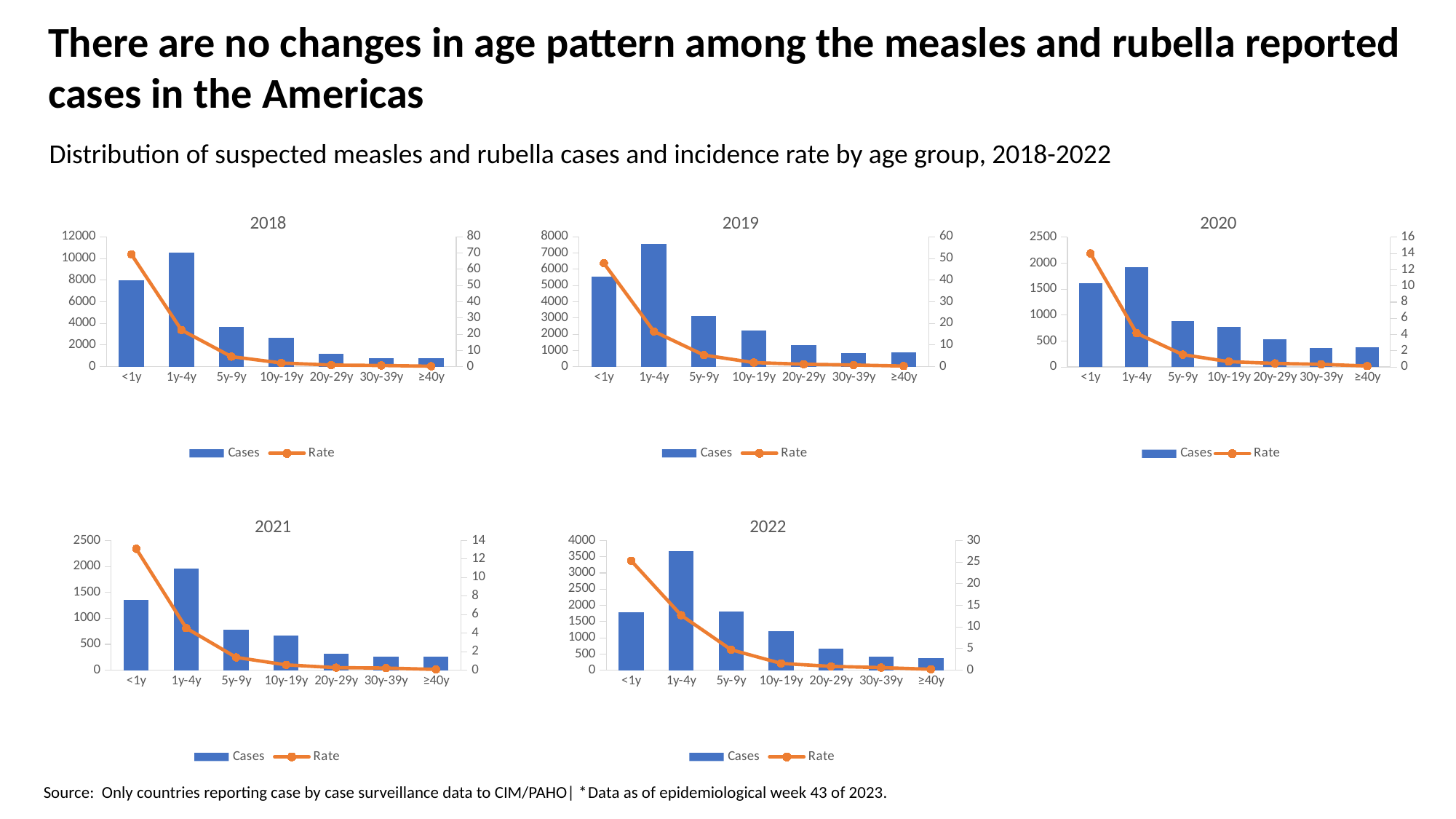
On the 2018 chart, is the number of cases for <1y greater or less than 6000? greater On the 2019 chart, is the number of cases for 1y-4y greater or less than 7000? greater On the 2018 chart, which age group has the highest number of cases? 1y-4y On the 2022 chart, is the number of cases for 1y-4y greater or less than 3000? greater On the 2019 chart, how many age groups are shown on the x axis? 7 How many charts are shown on the slide? 5 What kind of chart is the 2018 chart? Combined bar and line chart On the 2020 chart, which age group has the highest rate? <1y On the 2021 chart, how many series does the legend list? 2 On the 2022 chart, which has more cases, <1y or 10y-19y? <1y On the 2020 chart, does the Rate line rise or fall from <1y to ≥40y? fall